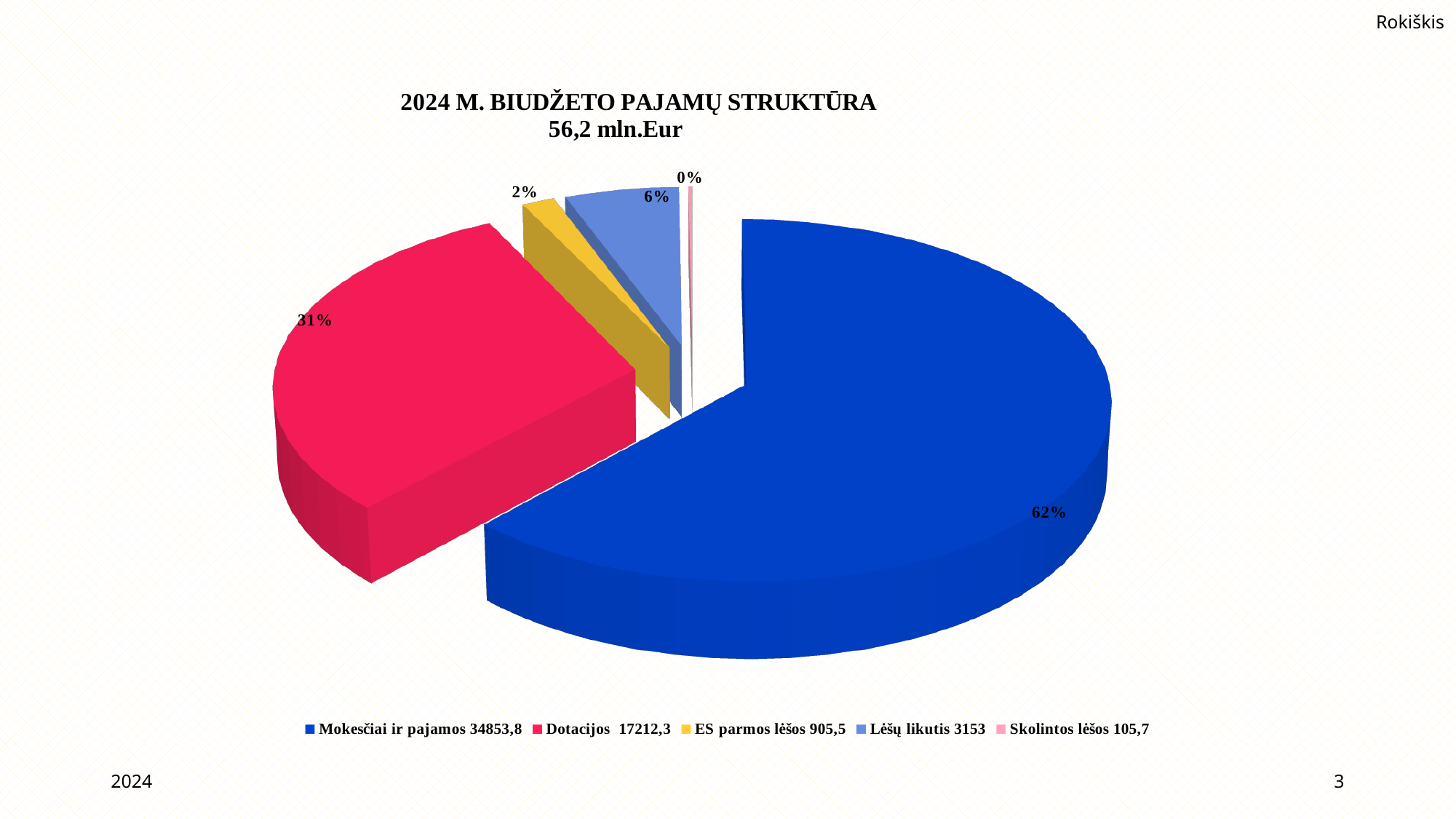
What kind of chart is shown on the slide? Pie chart What total amount is stated in the chart title? 56,2 mln.Eur What share of the pie does Skolintos lėšos represent? 0% What is the difference in percentage points between the Mokesčiai ir pajamos share and the Dotacijos share? 31 Which is larger, the share for Dotacijos or the share for Lėšų likutis? Dotacijos What share of the pie does Lėšų likutis represent? 6% Which category has the smallest slice of the pie? Skolintos lėšos What share of the pie does Dotacijos represent? 31% Which category has the largest slice of the pie? Mokesčiai ir pajamos How many categories does the pie chart have? 5